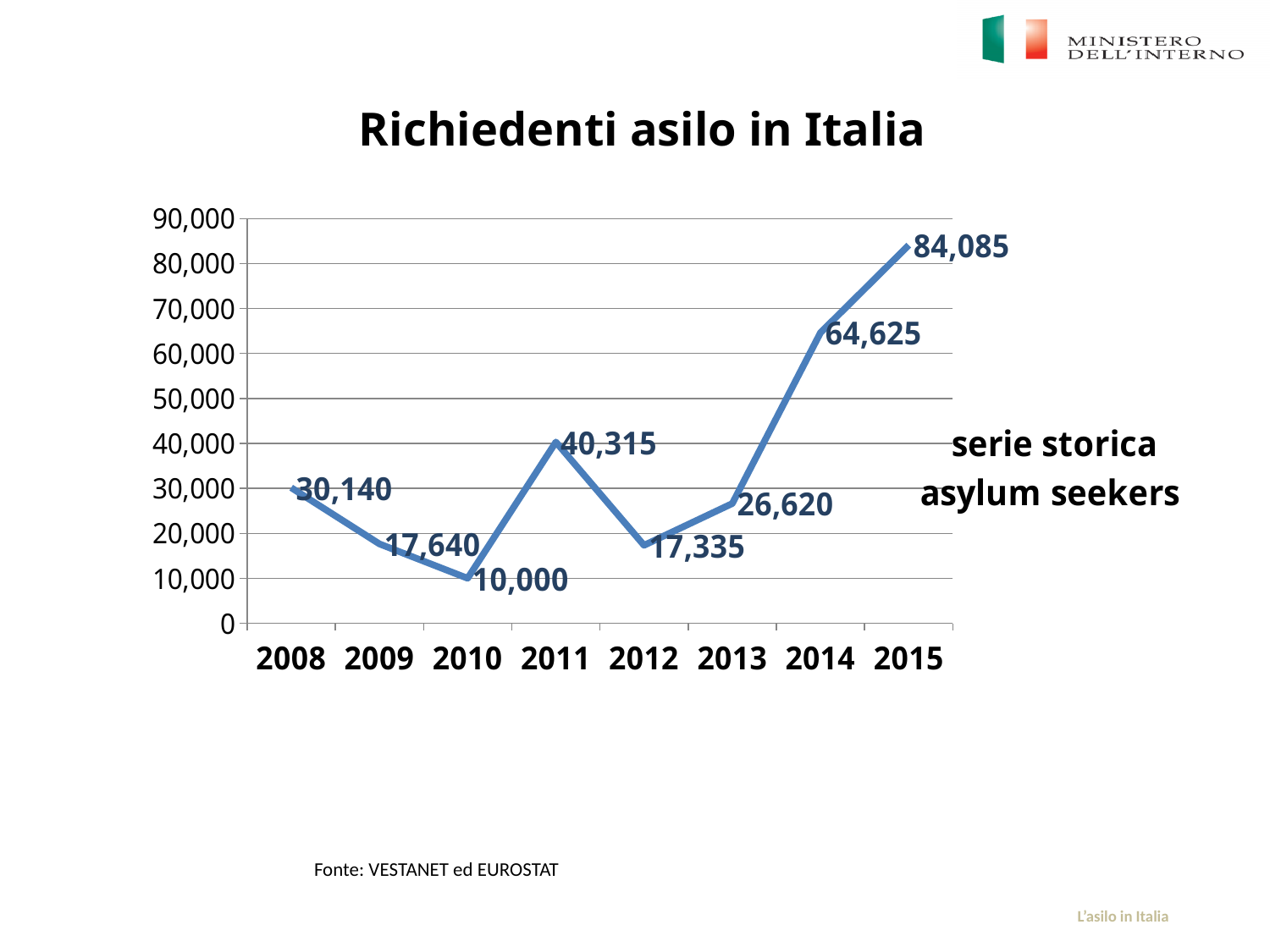
Which year has the highest value? 2015 What is the value for 2010? 10,000 What kind of chart is shown? line chart What is the value for 2011? 40,315 Is the value for 2014 greater or less than 60,000? greater What is the value for 2015? 84,085 What is the difference between the values for 2011 and 2010? 30,315 Which year has the lowest value? 2010 Which is larger, the value for 2008 or the value for 2013? 2008 Do the values rise or fall from 2013 to 2015? rise What is the difference between the values for 2015 and 2014? 19,460 How many years are plotted on the chart? 8